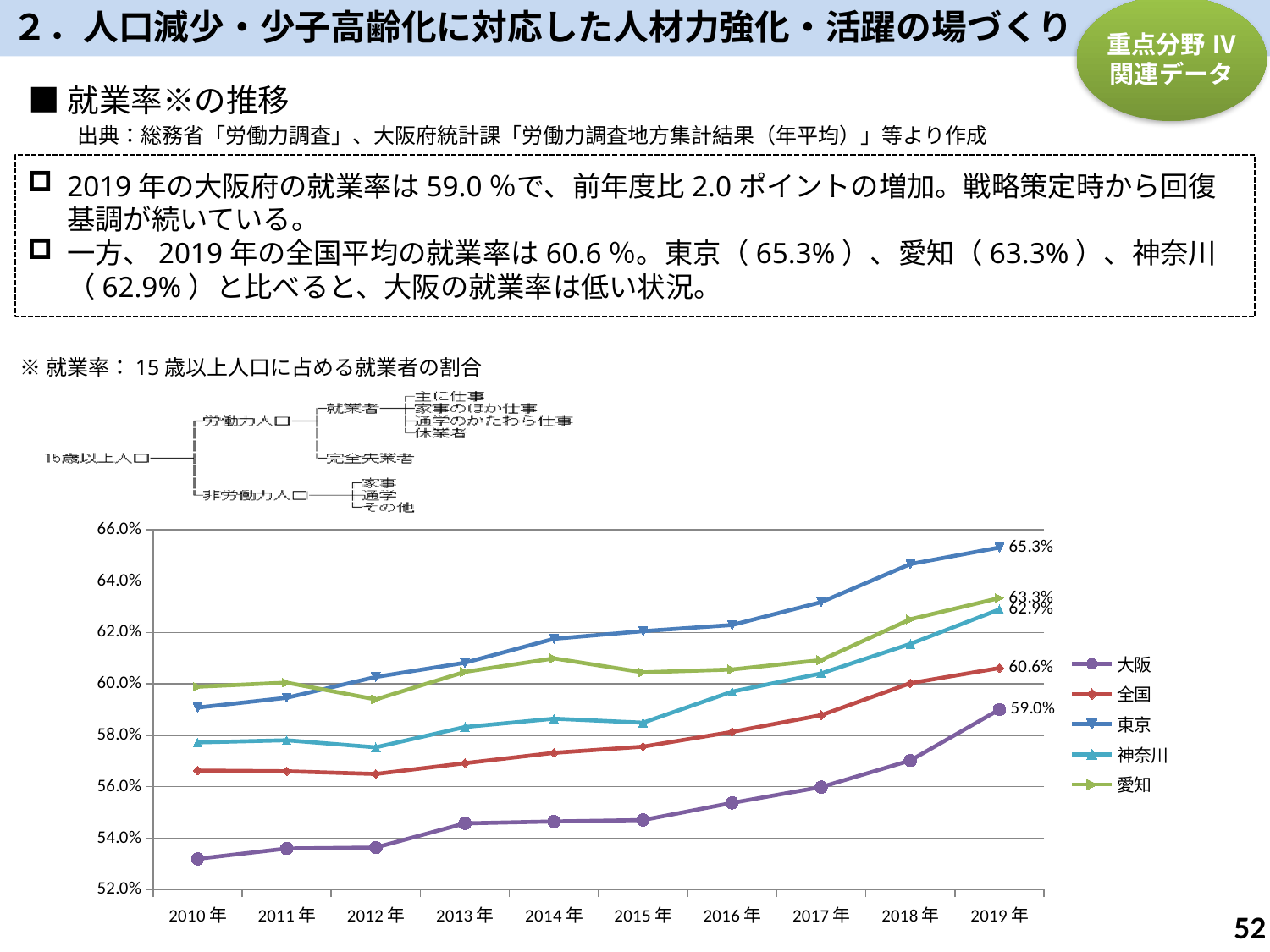
What is the difference between the 2019年 values for 東京 and 大阪? 6.3 points How many years are plotted along the x axis of the chart? 10 Does the 大阪 series rise or fall from 2010年 to 2019年? rise Is the value for 大阪 in 2010年 greater or less than 54.0%? less What is the value for 大阪 in 2019年? 59.0% What type of chart is shown on the slide? line chart What is the value for 東京 in 2019年? 65.3% What is the value for 神奈川 in 2019年? 62.9% How many series does the chart legend list? 5 What is the value for 全国 in 2019年? 60.6% Which series has the highest value in 2019年? 東京 Which series has the lowest value in 2019年? 大阪